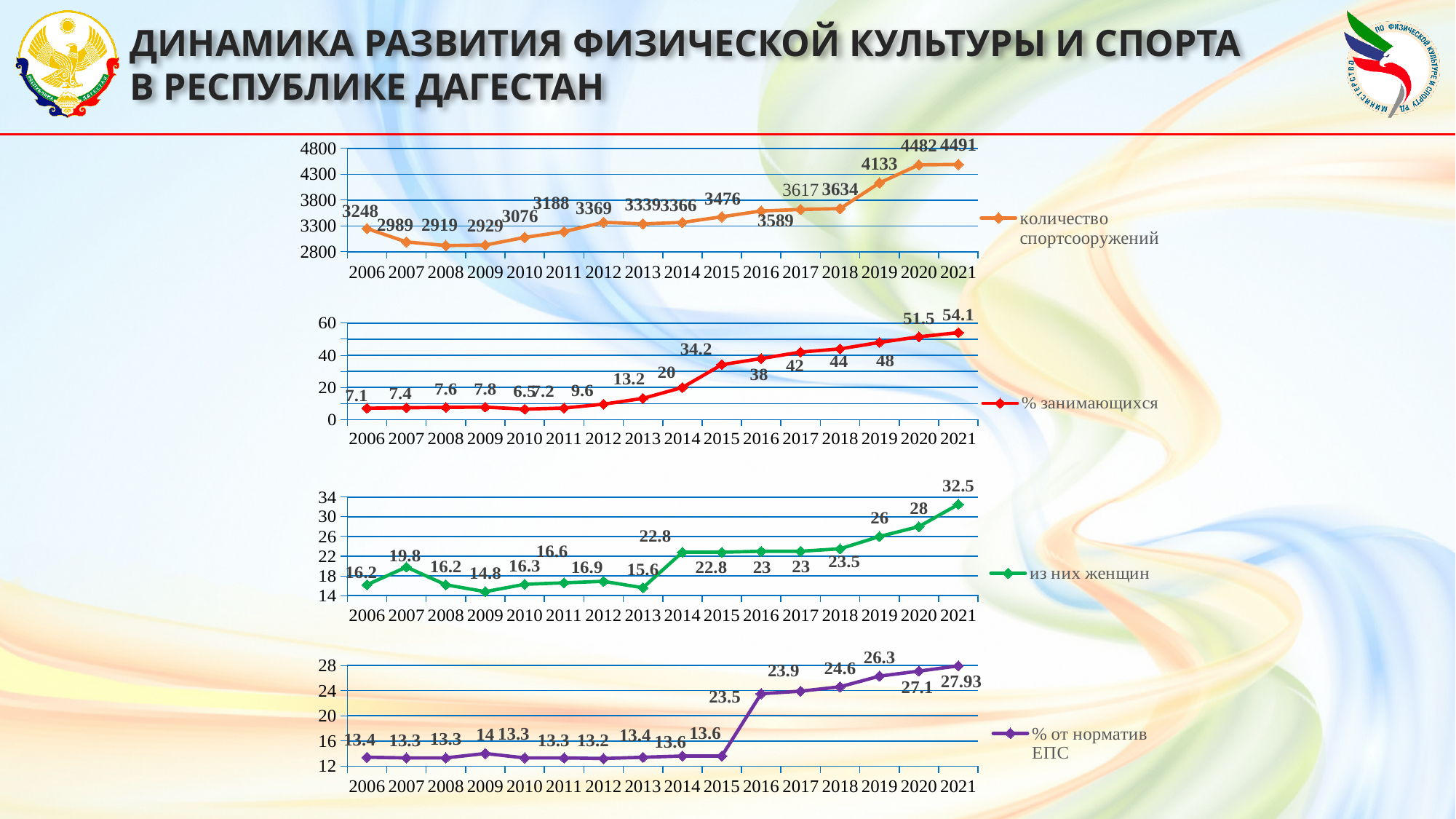
In the bottom chart (% от норматив ЕПС), what is the value for 2021? 27.93 In the third chart from the top (из них женщин), what is the value for 2009? 14.8 In the second chart from the top (% занимающихся), which year has the lowest value? 2010 In the third chart from the top (из них женщин), which is larger, the value for 2007 or the value for 2013? 2007 In the top chart (количество спортсооружений), which year has the lowest value? 2008 What kind of chart is the top chart (количество спортсооружений)? line chart In the top chart (количество спортсооружений), what is the difference between the values for 2020 and 2019? 349 In the second chart from the top (% занимающихся), what is the value for 2015? 34.2 In the bottom chart (% от норматив ЕПС), what is the difference between the values for 2016 and 2015? 9.9 In the top chart (количество спортсооружений), what is the value for 2021? 4491 In the second chart from the top (% занимающихся), which year has the highest value? 2021 How many years are plotted on the x axis of the bottom chart (% от норматив ЕПС)? 16